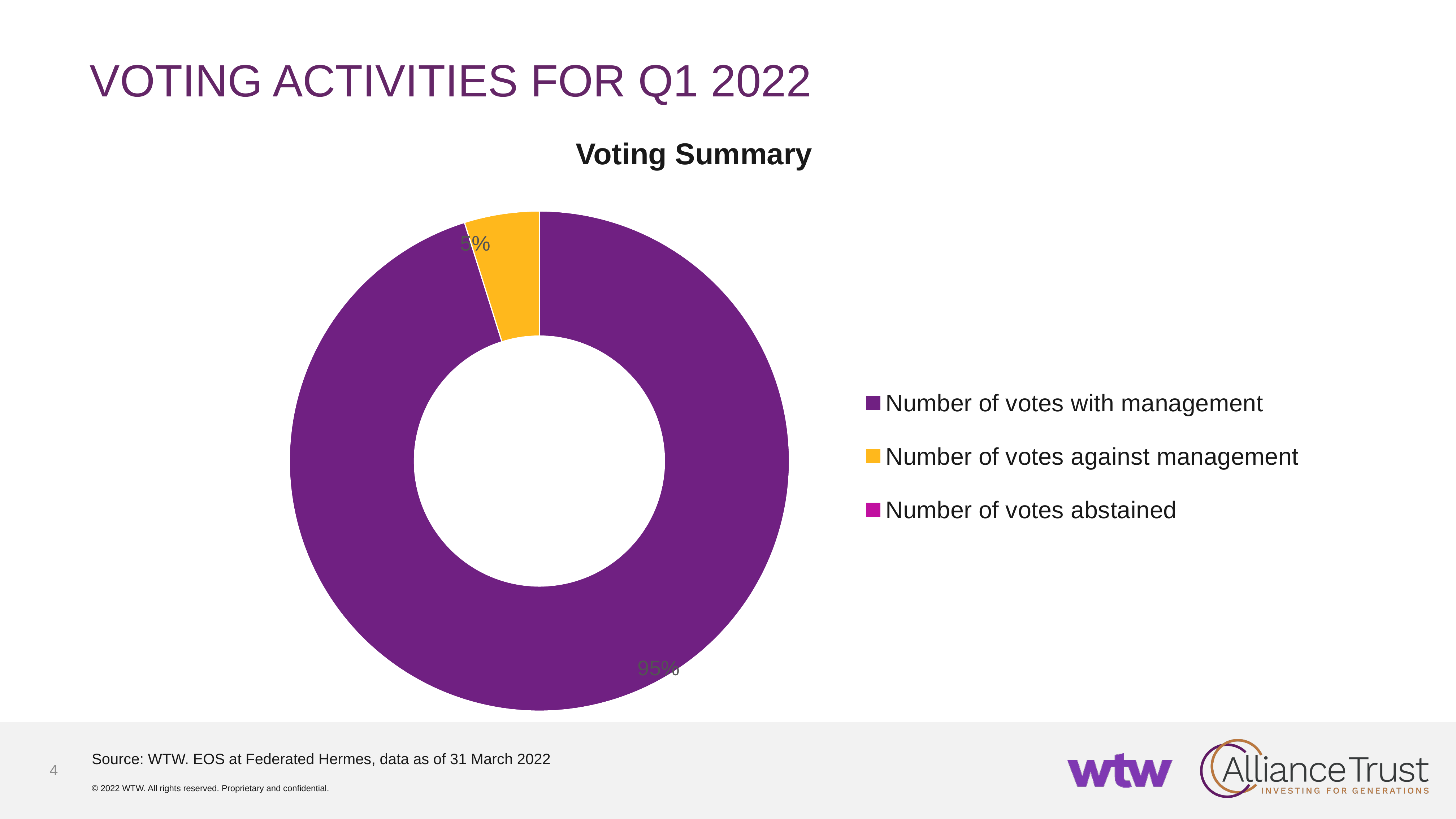
What share of the Voting Summary chart is Number of votes with management? 95% What colour represents Number of votes against management in the Voting Summary chart? Yellow What kind of chart is the Voting Summary chart? Doughnut chart Is the share for Number of votes with management greater or less than 50%? greater What share of the Voting Summary chart is Number of votes against management? 5% Which category has the largest share in the Voting Summary chart? Number of votes with management How many entries does the legend of the Voting Summary chart list? 3 What is the title of the chart on the slide? Voting Summary What is the difference in percentage points between the share of votes with management and the share of votes against management? 90 Which of the two labelled slices is larger: Number of votes with management or Number of votes against management? Number of votes with management